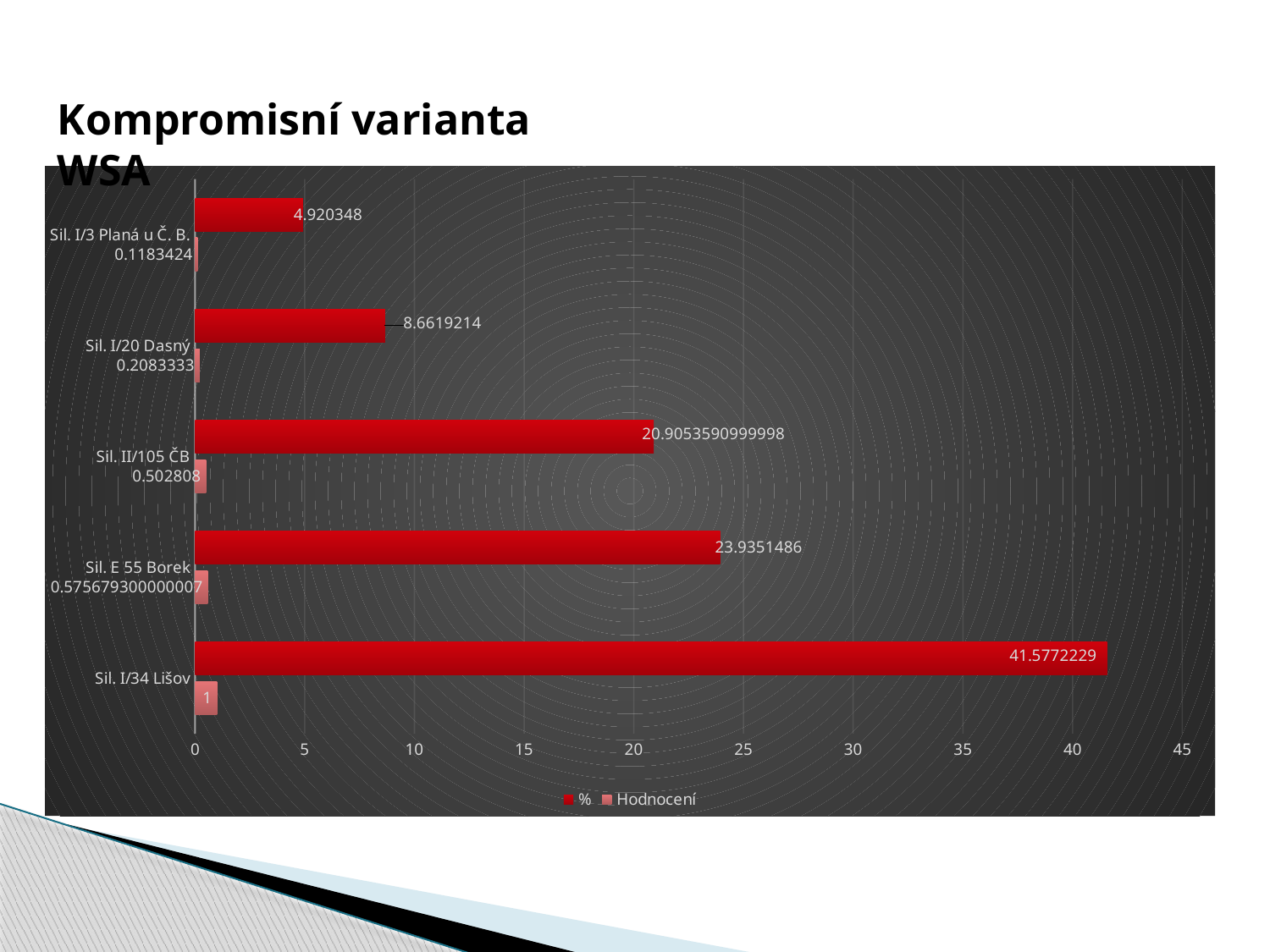
What are the two series named in the legend? % and Hodnocení What is the Hodnocení value for Sil. I/34 Lišov? 1 Is the % value for Sil. I/34 Lišov greater or less than 40? greater What kind of chart is shown on the slide? bar chart What is the Hodnocení value for Sil. II/105 ČB? 0.502808 Which category has the highest % value? Sil. I/34 Lišov What is the % value for Sil. I/34 Lišov? 41.5772229 Which has a larger % value, Sil. E 55 Borek or Sil. II/105 ČB? Sil. E 55 Borek Which category has the lowest % value? Sil. I/3 Planá u Č. B. What is the % value for Sil. I/20 Dasný? 8.6619214 How many series does the legend list? 2 How many categories are shown on the chart? 5